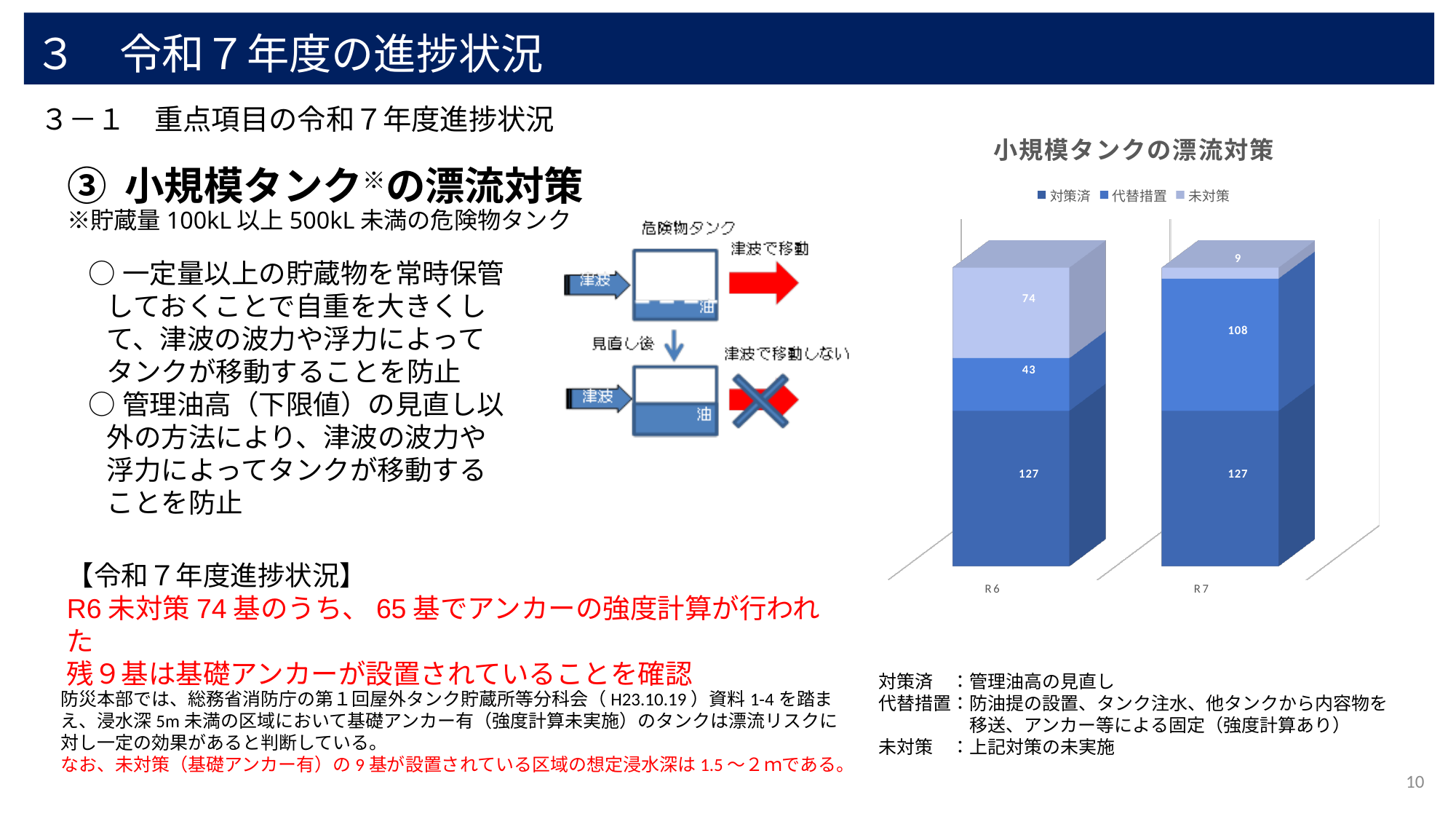
Which series has the largest value in the R7 bar? 対策済 What is the difference between the 未対策 values for R6 and R7? 65 What is the title of the chart on the slide? 小規模タンクの漂流対策 What is the value of 未対策 for R7? 9 What is the value of 対策済 for R6? 127 What is the value of 未対策 for R6? 74 How many categories are shown on the x axis of the chart? 2 What is the value of 代替措置 for R7? 108 How many series does the chart legend list? 3 What type of chart is shown on the slide? Stacked bar chart Which is larger, the 代替措置 value for R6 or for R7? R7 What is the total of the stacked bar for R6? 244